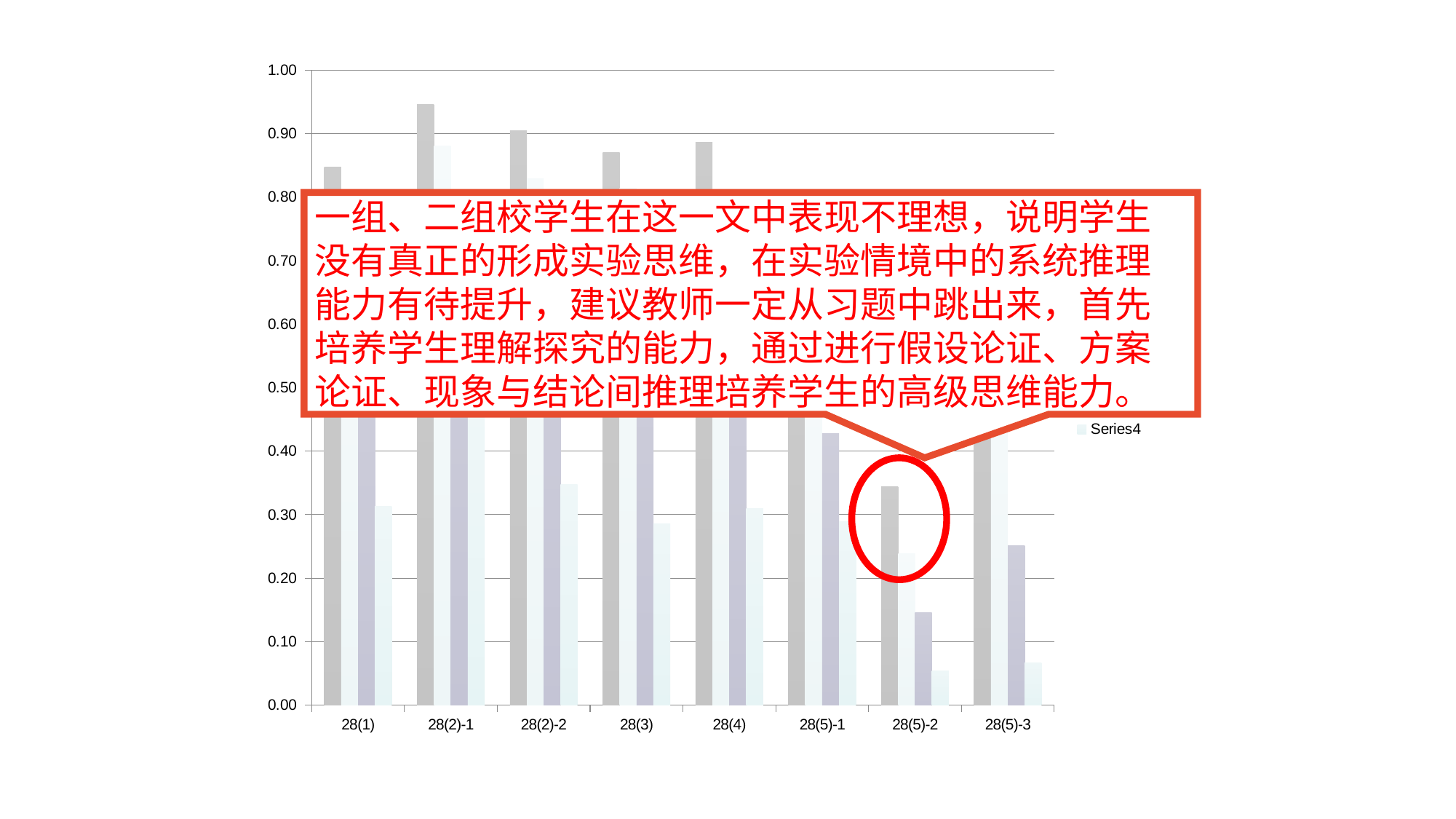
Which legend entry is visible on the chart? Series4 Among the first (gray) bars, which category has the lowest value? 28(5)-2 How many categories are shown on the x axis of the chart? 8 Is the Series4 value for 28(2)-1 greater or less than 0.80? less Is the Series4 value for 28(5)-2 greater or less than 0.10? less Which is larger: the first (gray) bar for 28(1) or the first (gray) bar for 28(5)-2? 28(1) What is the highest value shown on the y axis of the chart? 1.00 Is the value of the first (gray) bar for 28(5)-2 greater or less than 0.40? less What kind of chart is shown on the slide? bar chart Among the first (gray) bars, which category has the highest value? 28(2)-1